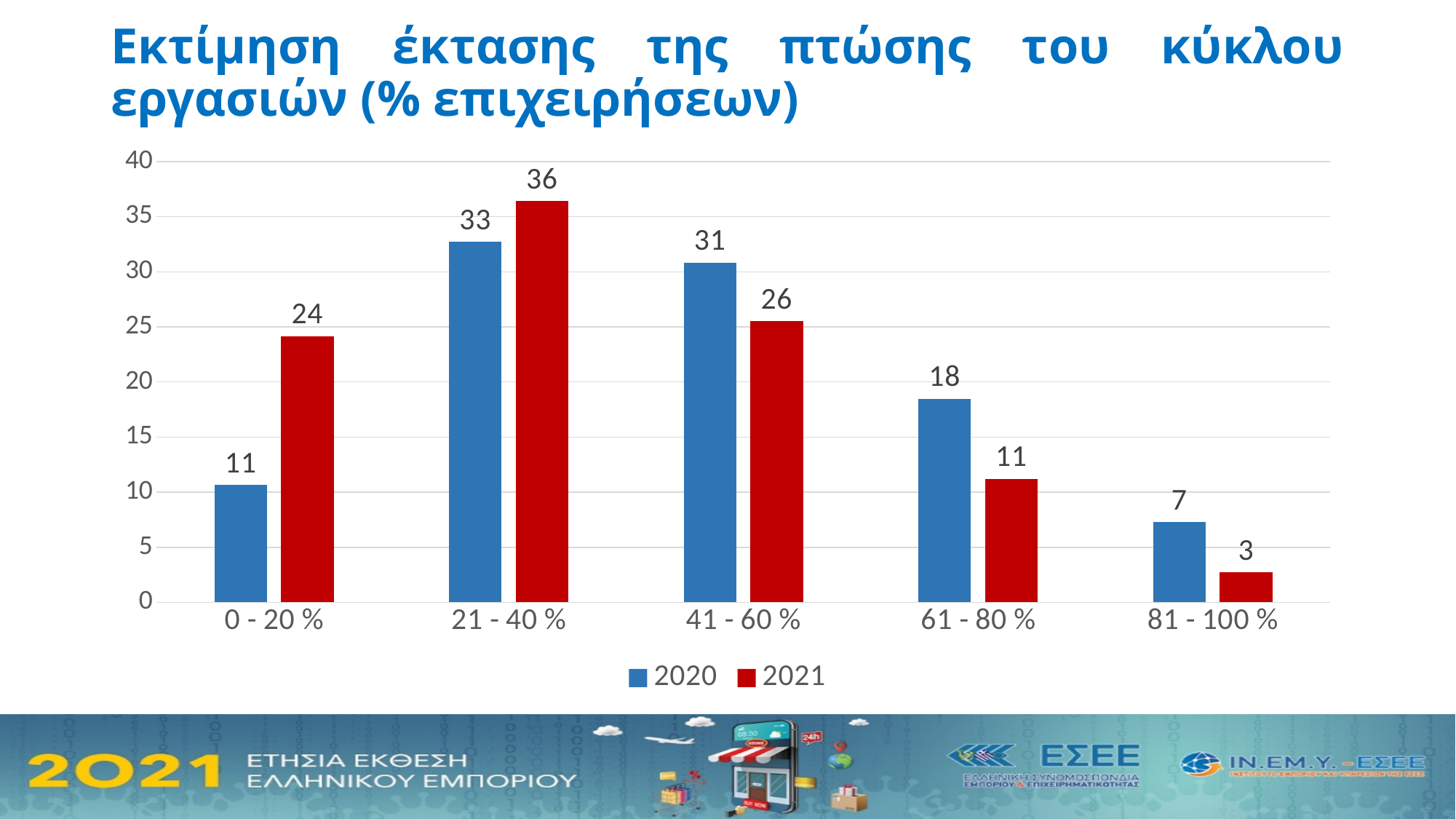
What is the value for 2020 in the 81 - 100 % category? 7 What kind of chart is shown on the slide? bar chart Which is larger in the 0 - 20 % category, the 2020 value or the 2021 value? 2021 What is the value for 2021 in the 0 - 20 % category? 24 Which category has the highest value for the 2021 series? 21 - 40 % Which category has the lowest value for the 2020 series? 81 - 100 % Is the value for 2021 in the 41 - 60 % category greater or less than 30? less Which colour represents the 2021 series in the legend? red What is the difference between the 2020 and 2021 values in the 61 - 80 % category? 7 What is the value for 2020 in the 41 - 60 % category? 31 How many series does the legend list? 2 How many categories are shown on the x axis? 5